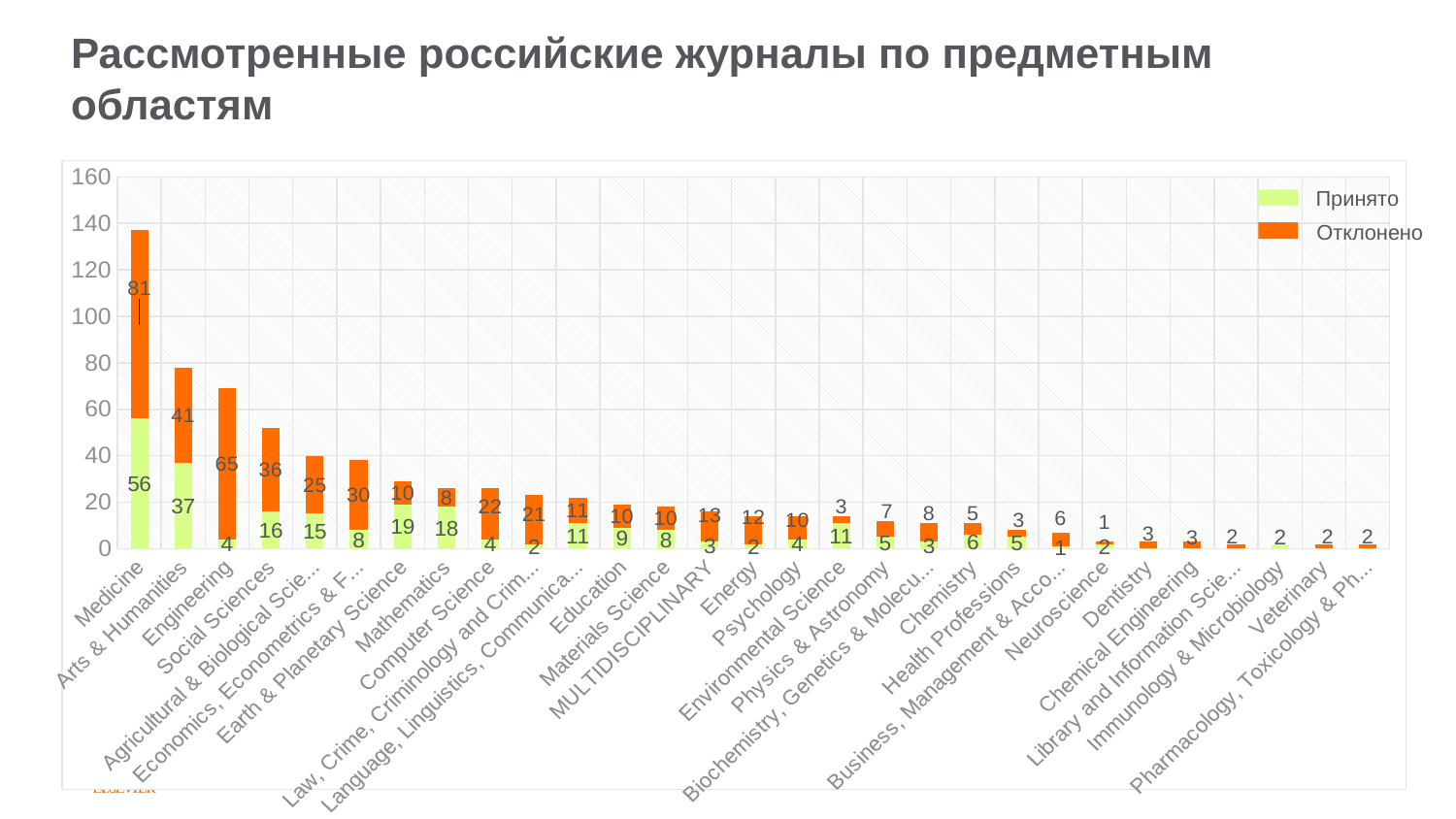
What type of chart is shown on the slide? stacked bar chart What is the Отклонено value for Social Sciences? 36 What are the two series named in the legend? Принято and Отклонено What is the Принято value for Arts & Humanities? 37 Which category has the highest Отклонено value? Medicine What is the Принято value for Medicine? 56 How many series does the legend list? 2 What is the total of the stacked bar for Medicine? 137 What is the difference between the Отклонено and Принято values for Engineering? 61 What is the total of the stacked bar for Arts & Humanities? 78 What is the Отклонено value for Engineering? 65 Which is larger for Mathematics: the Принято value or the Отклонено value? Принято